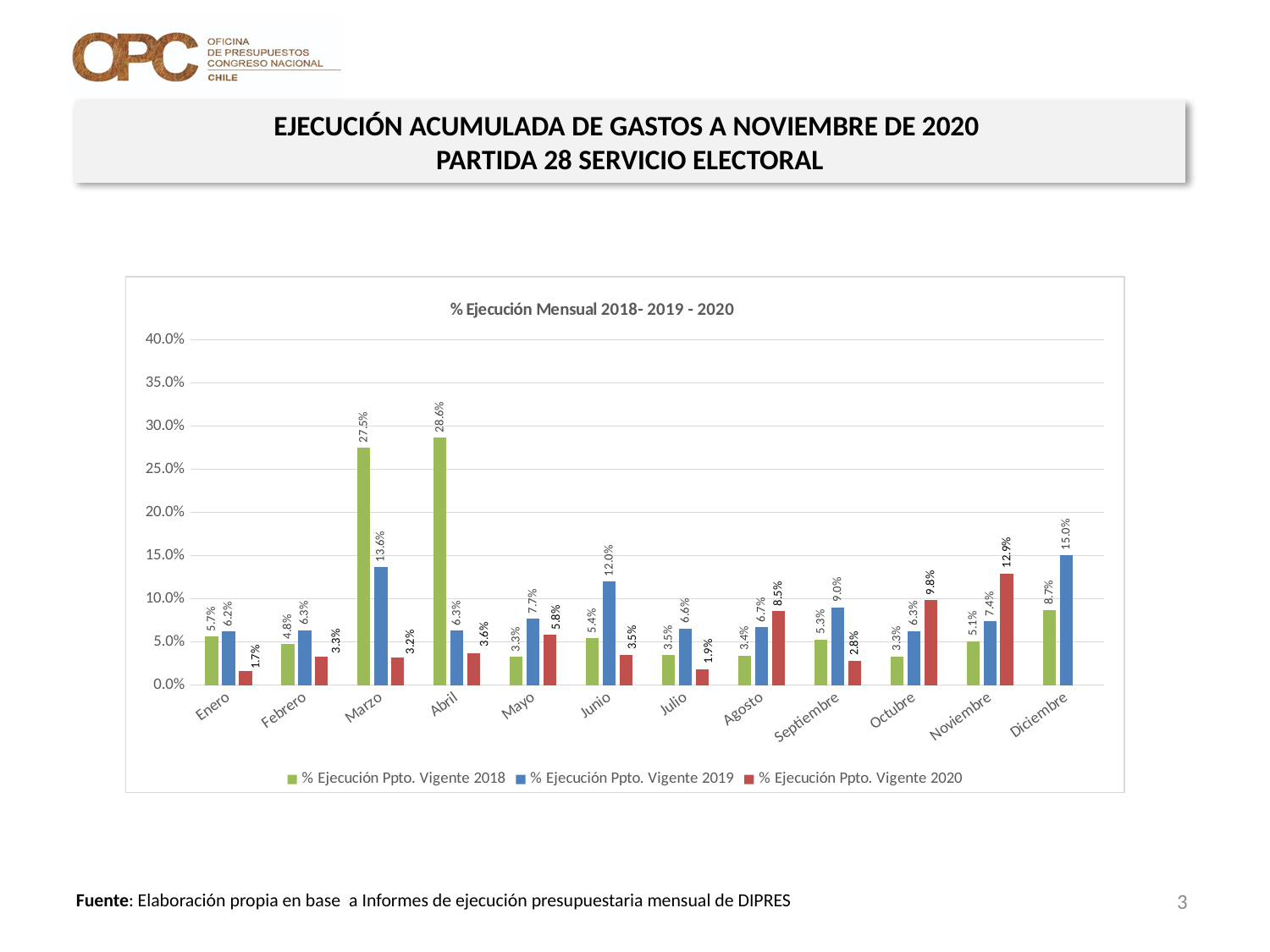
What type of chart is shown on the slide? Bar chart How many series does the legend list? 3 What is the title of the chart? % Ejecución Mensual 2018- 2019 - 2020 Which month has the highest value for % Ejecución Ppto. Vigente 2019? Diciembre Which is larger for Octubre: the 2019 value or the 2020 value? 2020 value (9.8%) Is the value of % Ejecución Ppto. Vigente 2018 for Marzo greater or less than 25.0%? greater What is the value of % Ejecución Ppto. Vigente 2020 for Noviembre? 12.9% What is the value of % Ejecución Ppto. Vigente 2019 for Junio? 12.0% Which month has the lowest value for % Ejecución Ppto. Vigente 2020? Enero What is the difference between the 2018 and 2019 values for Marzo? 13.9% What is the value of % Ejecución Ppto. Vigente 2018 for Abril? 28.6% How many months are shown on the x axis? 12